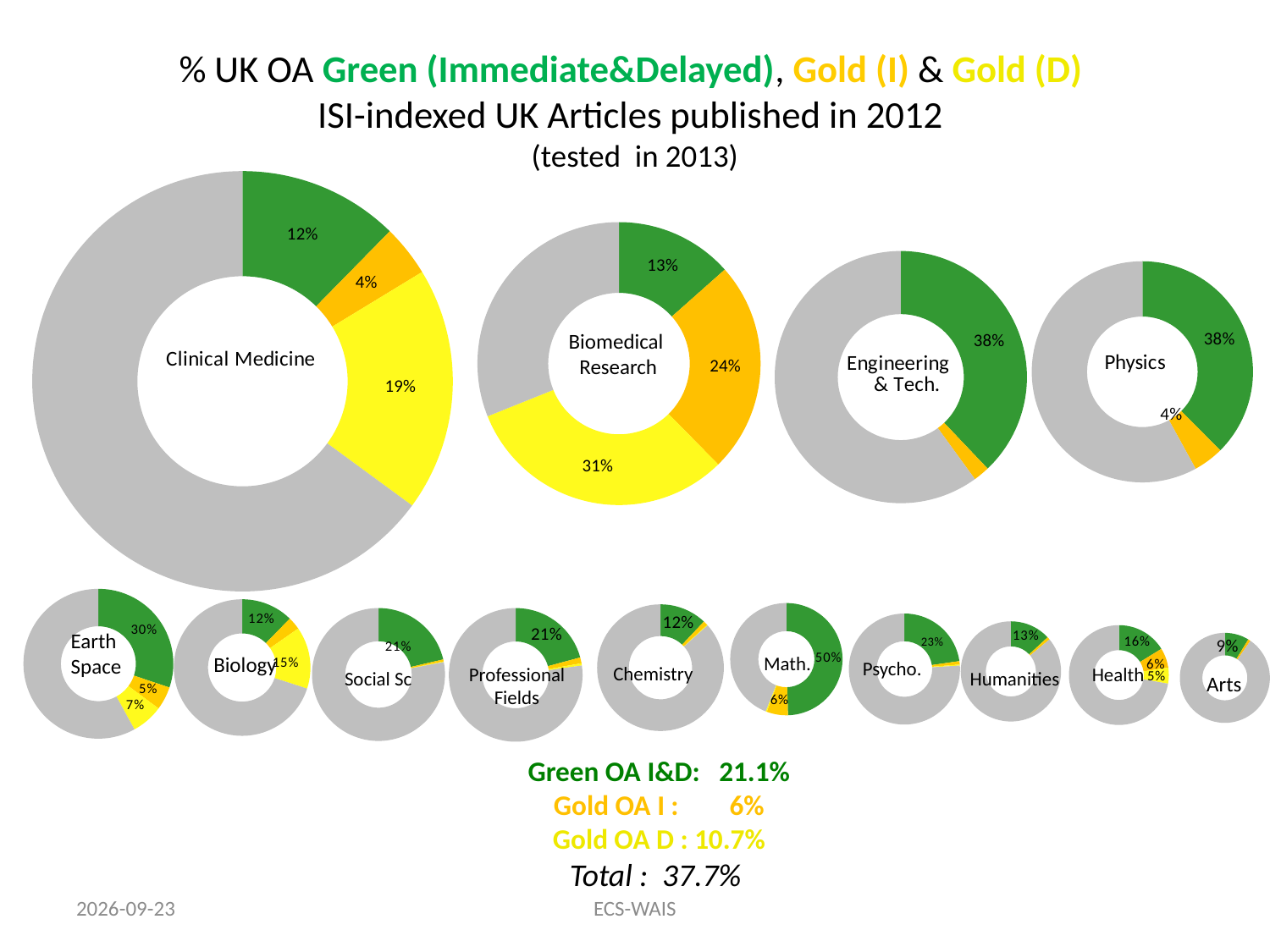
In the Biomedical Research chart, what percentage is shown for the yellow (Gold D) slice? 31% In the Clinical Medicine chart, what percentage is shown for the green (Green OA) slice? 12% Which chart has the larger green slice, Earth Space or Chemistry? Earth Space Across all the charts, which field has the largest green (Green OA) percentage? Math. In the Health chart, what percentage is shown for the green slice? 16% In the Math. chart, what percentage is shown for the green slice? 50% What kind of chart is used for each field on this slide? Donut (pie) chart What is the total open access percentage stated at the bottom of the slide? 37.7% What is the difference between the yellow (Gold D) slice in the Biomedical Research chart and the yellow slice in the Clinical Medicine chart? 12% In the Physics chart, what percentage is shown for the green slice? 38% In the Biomedical Research chart, what percentage is shown for the orange (Gold I) slice? 24% How many field charts are shown on the slide? 14